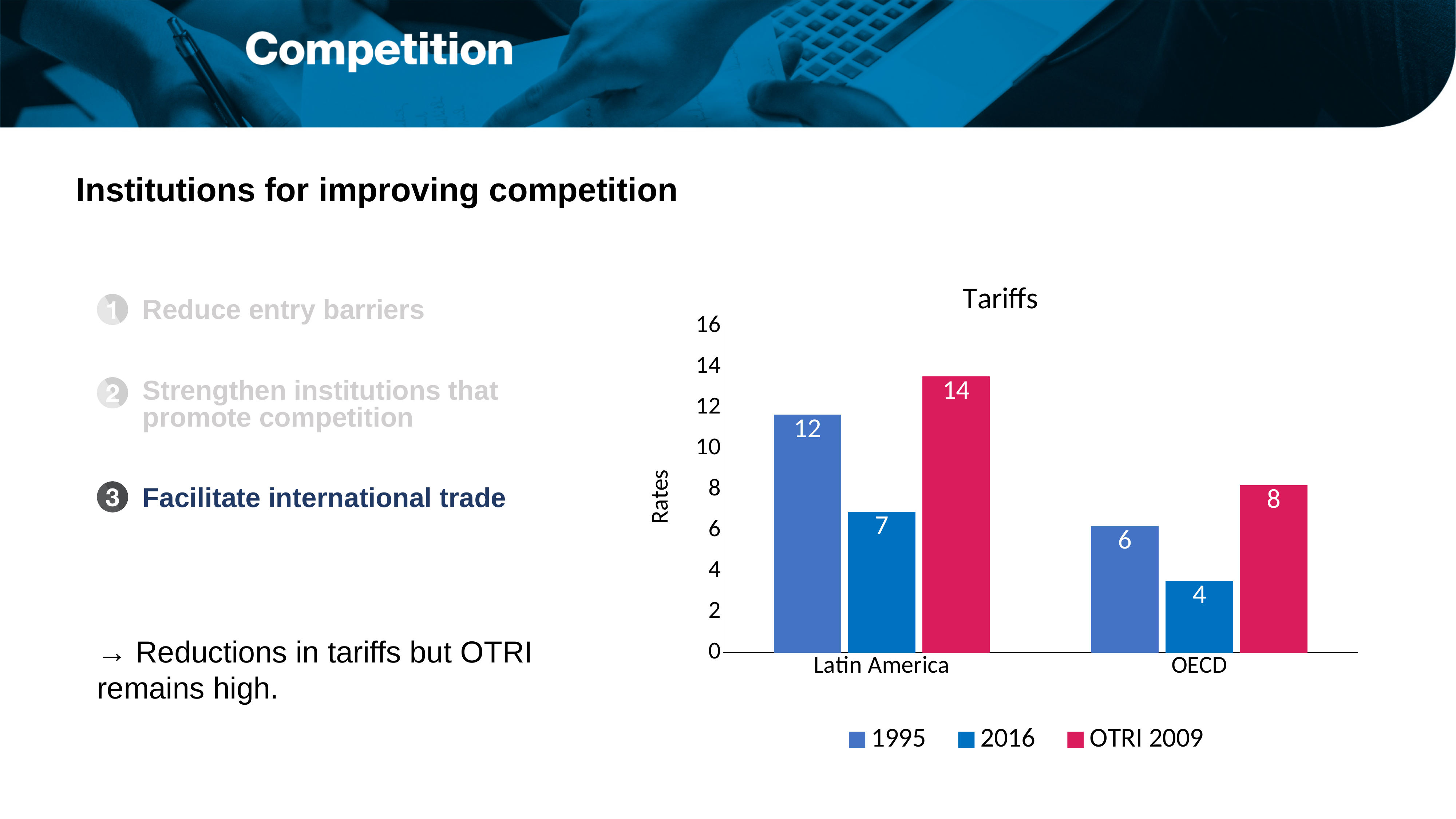
What is the OTRI 2009 value for OECD? 8 What is the title of the chart? Tariffs How many series does the legend list? 3 What is the OTRI 2009 value for Latin America? 14 Which series has the lowest value in OECD? 2016 What is the difference between the 1995 and 2016 values for Latin America? 5 Which is larger, the 2016 value for Latin America or the 2016 value for OECD? Latin America What kind of chart is shown? Bar chart How many categories are shown on the x axis? 2 What is the value for 2016 in OECD? 4 Which category has the highest OTRI 2009 value? Latin America What is the value for 1995 in Latin America? 12